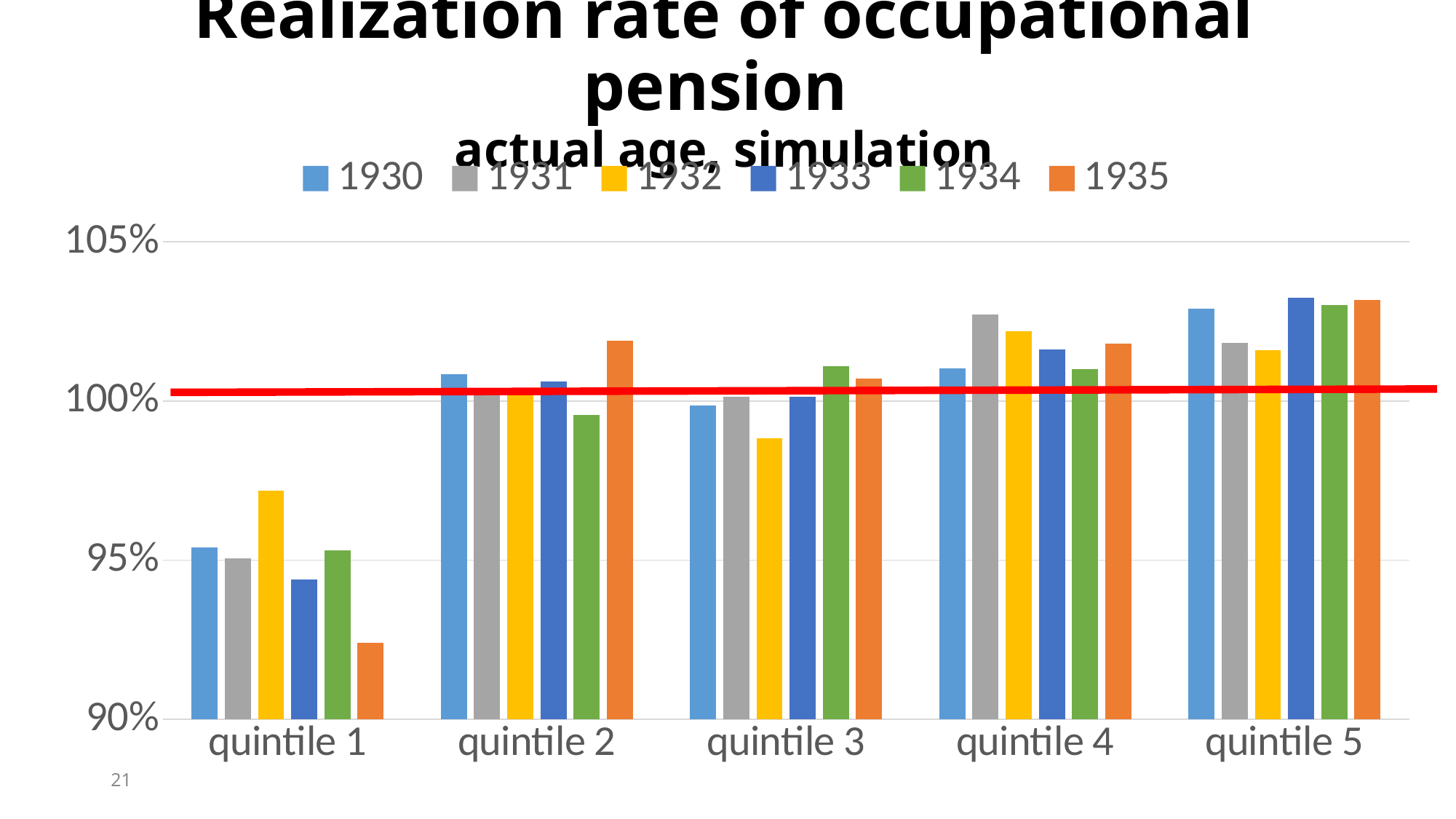
Is the value for 1935 in quintile 2 greater or less than 100%? greater Within quintile 1, which series has the lowest value? 1935 Is the value for 1935 in quintile 1 greater or less than 95%? less In quintile 2, which is larger: the value for 1934 or the value for 1935? 1935 How many series does the legend list? 6 How many quintile categories are shown on the x axis? 5 Is the value for 1932 in quintile 3 greater or less than 100%? less Within quintile 1, which series has the highest value? 1932 Which series is listed first in the legend? 1930 What kind of chart is shown on the slide? bar chart